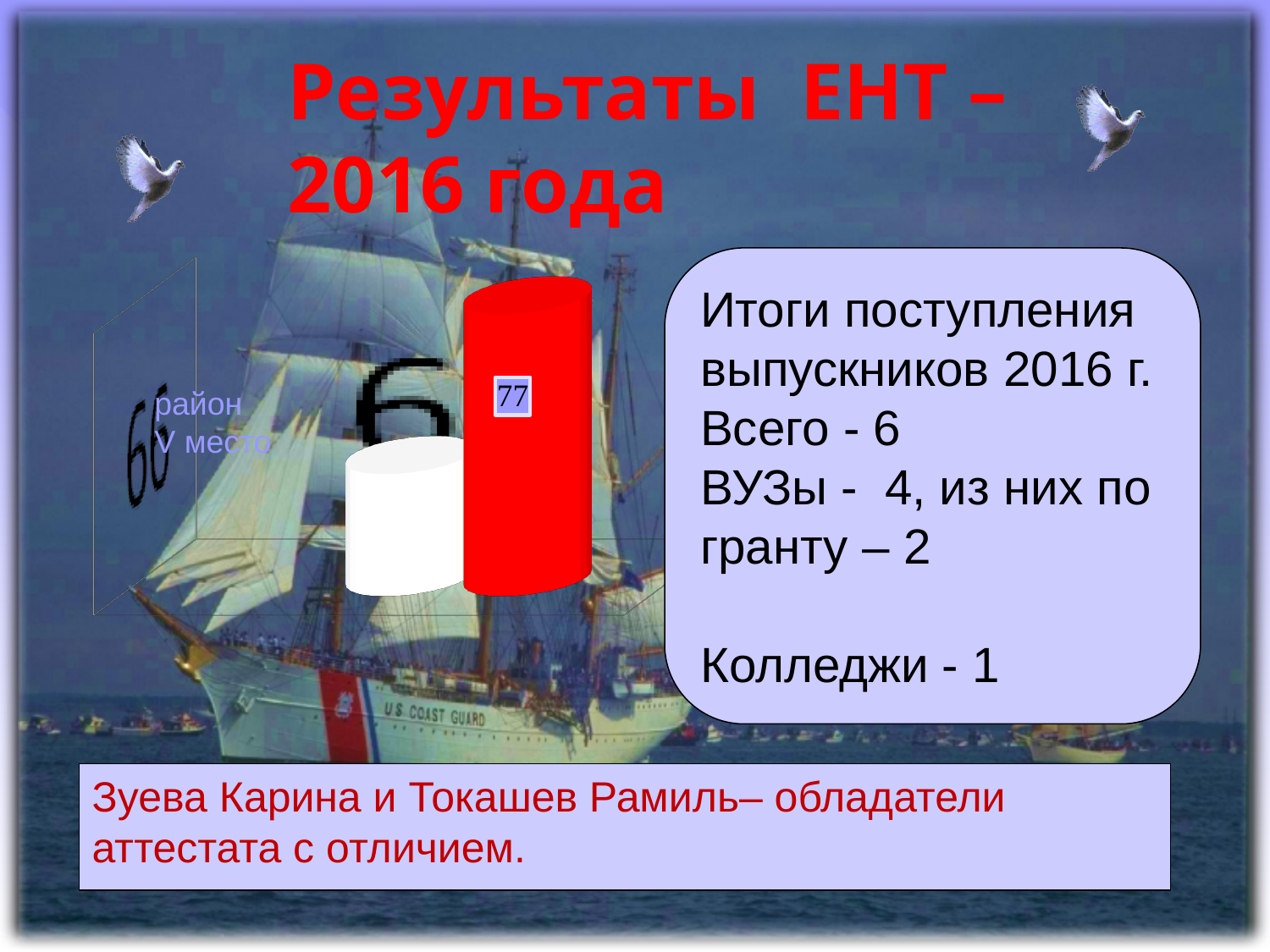
What colour is the bar labelled 77? red What value is printed on the red bar of the chart? 77 What text appears next to the white bar in the chart? район V место Which bar is taller in the chart, the red one or the white one? the red one Which bar in the chart has the highest value? the red bar (77) How many bars does the chart show? 2 What kind of chart is shown on the slide? bar chart